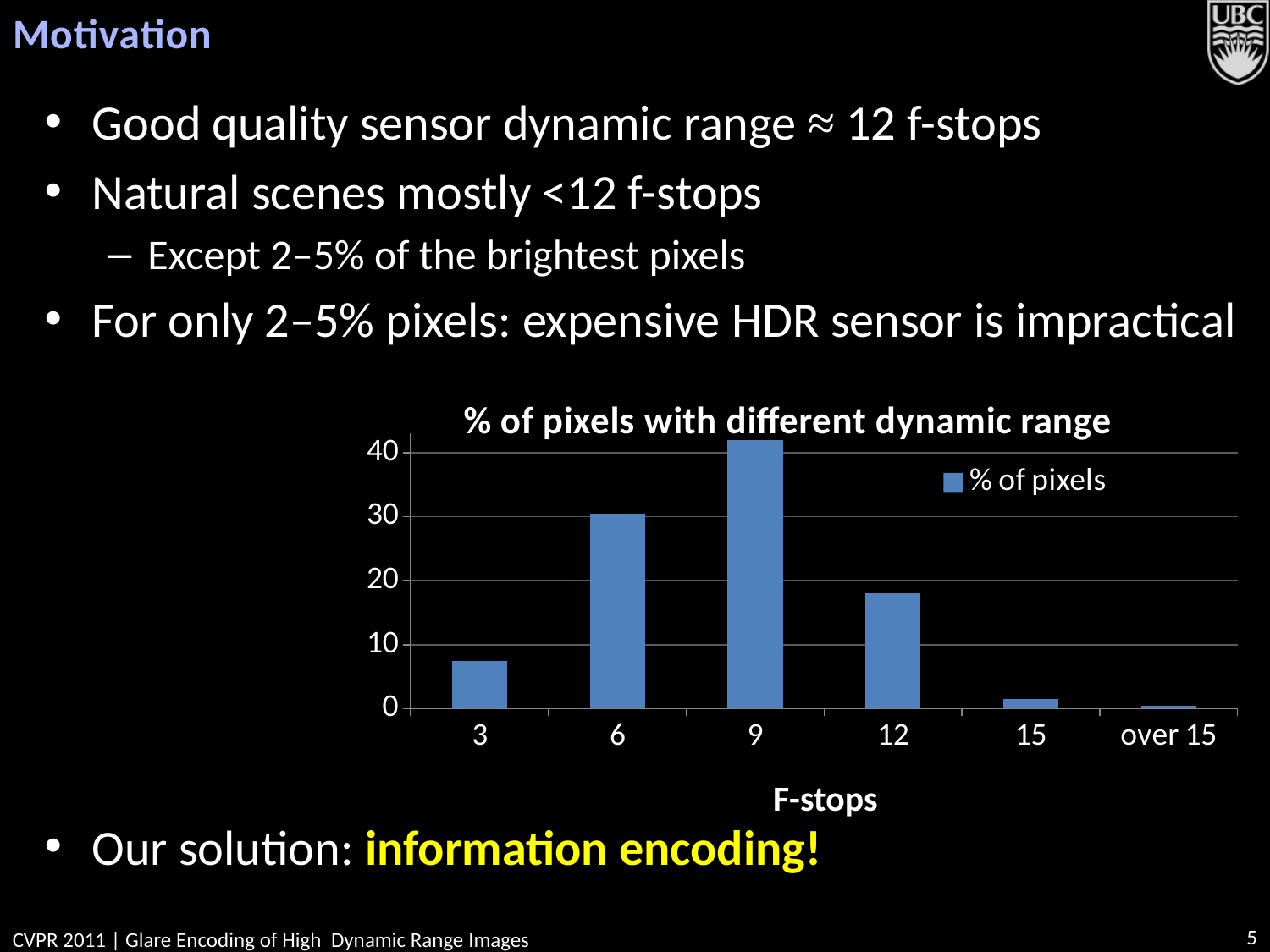
What kind of chart is shown on the slide? bar chart What is the title of the chart? % of pixels with different dynamic range Do the values rise or fall along the x axis from 9 f-stops to over 15 f-stops? fall Is the value for 12 f-stops greater or less than 20? less How many categories are shown on the x axis of the chart? 6 Which f-stop category has the highest % of pixels? 9 Which has a larger % of pixels, 6 f-stops or 12 f-stops? 6 Is the value for 9 f-stops greater or less than 40? greater What is the label on the x axis of the chart? F-stops How many series does the chart's legend list? 1 Which f-stop category has the lowest % of pixels? over 15 Is the value for 3 f-stops greater or less than 10? less